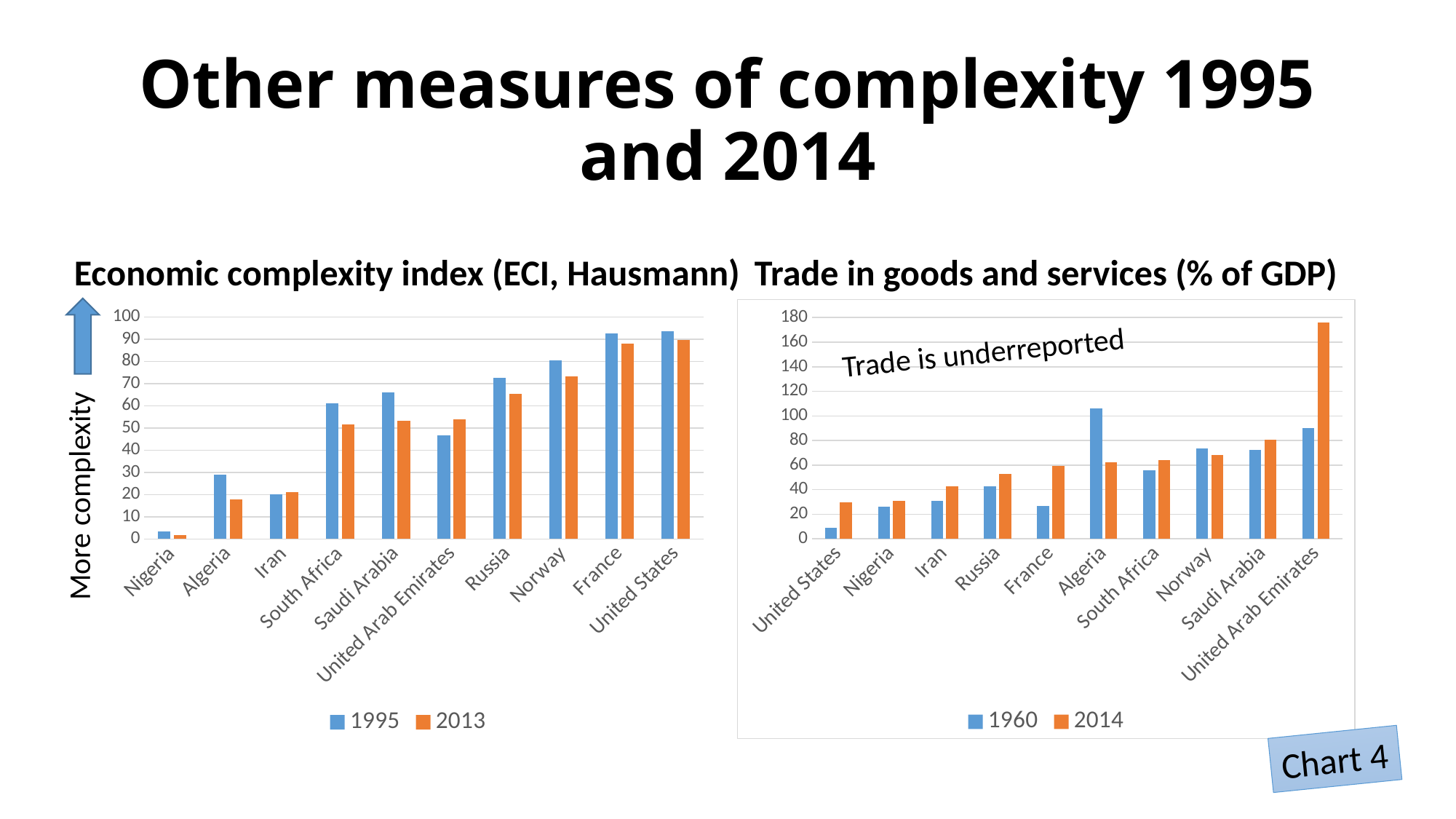
In the Trade in goods and services (% of GDP) chart, which country has the highest 2014 value? United Arab Emirates In the Economic complexity index (ECI, Hausmann) chart, is the 1995 value for South Africa greater or less than 50? greater What are the two legend entries of the Trade in goods and services (% of GDP) chart? 1960 and 2014 How many series does the legend of the Trade in goods and services (% of GDP) chart list? 2 What kind of chart is the Economic complexity index (ECI, Hausmann) chart on the left? bar chart In the Trade in goods and services (% of GDP) chart, which country has the highest 1960 value? Algeria In the Economic complexity index (ECI, Hausmann) chart, which is larger for Algeria: the 1995 value or the 2013 value? 1995 How many countries are shown on the Economic complexity index (ECI, Hausmann) chart? 10 In the Trade in goods and services (% of GDP) chart, is the 1960 value for United States greater or less than 20? less In the Trade in goods and services (% of GDP) chart, which is larger for France: the 1960 value or the 2014 value? 2014 In the Trade in goods and services (% of GDP) chart, is the 1960 value for Algeria greater or less than 100? greater In the Economic complexity index (ECI, Hausmann) chart, which country has the lowest 1995 value? Nigeria